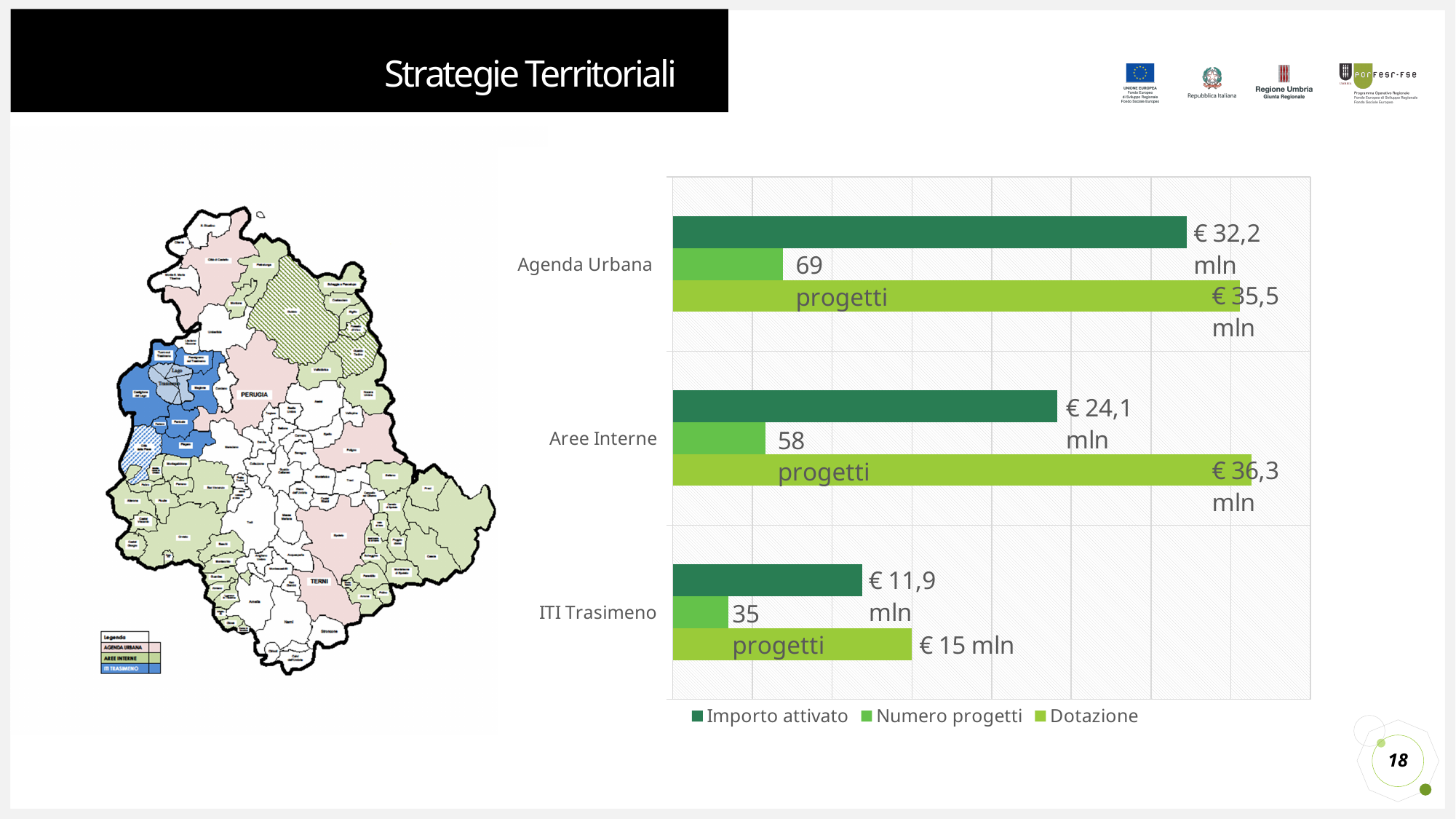
How many categories are shown on the chart? 3 How many progetti are shown for ITI Trasimeno? 35 progetti Which series is shown in the darkest green colour in the legend? Importo attivato How many series does the chart legend list? 3 Which is larger for Aree Interne: Importo attivato or Dotazione? Dotazione What is the Importo attivato value for Agenda Urbana? € 32,2 mln What is the Dotazione value for Aree Interne? € 36,3 mln What is the difference in Numero progetti between Agenda Urbana and ITI Trasimeno? 34 progetti What is the Dotazione value for ITI Trasimeno? € 15 mln Which category has the highest Numero progetti? Agenda Urbana Which category has the lowest Importo attivato? ITI Trasimeno What kind of chart is shown on the slide? bar chart